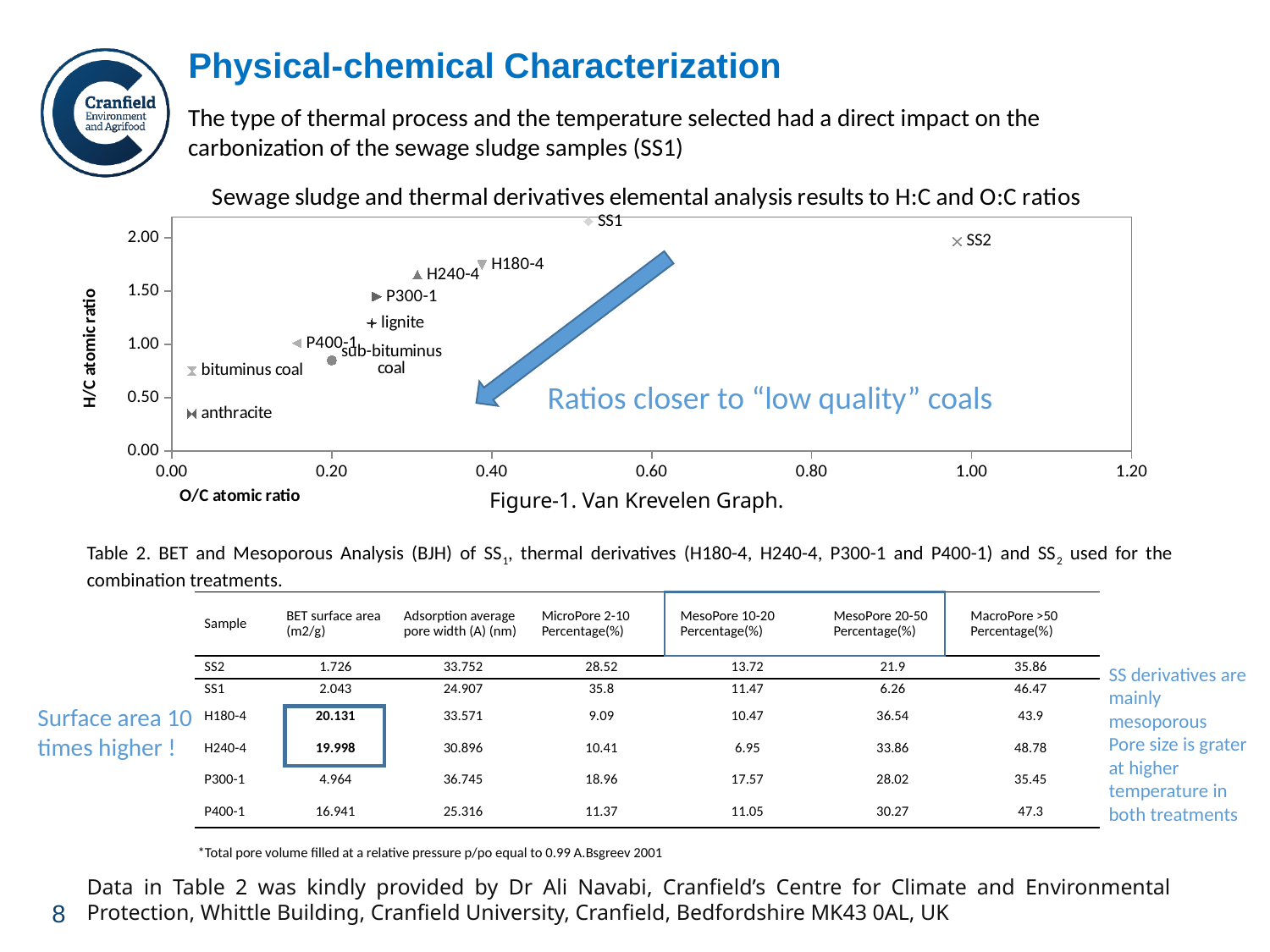
Is the H/C atomic ratio for anthracite greater or less than 0.50? less Is the O/C atomic ratio for SS2 greater or less than 0.80? greater Is the H/C atomic ratio for H180-4 greater or less than 1.50? greater How many labelled data points are plotted on the chart? 10 Which labelled point has the highest O/C atomic ratio on the chart? SS2 What is the title of the chart on the slide? Sewage sludge and thermal derivatives elemental analysis results to H:C and O:C ratios Which labelled point has the highest H/C atomic ratio on the chart? SS1 What kind of chart is Figure-1, the Van Krevelen Graph? scatter chart Which labelled point has the lowest H/C atomic ratio on the chart? anthracite Which has the larger H/C atomic ratio on the chart, H180-4 or P400-1? H180-4 What is the label of the vertical axis of the chart? H/C atomic ratio